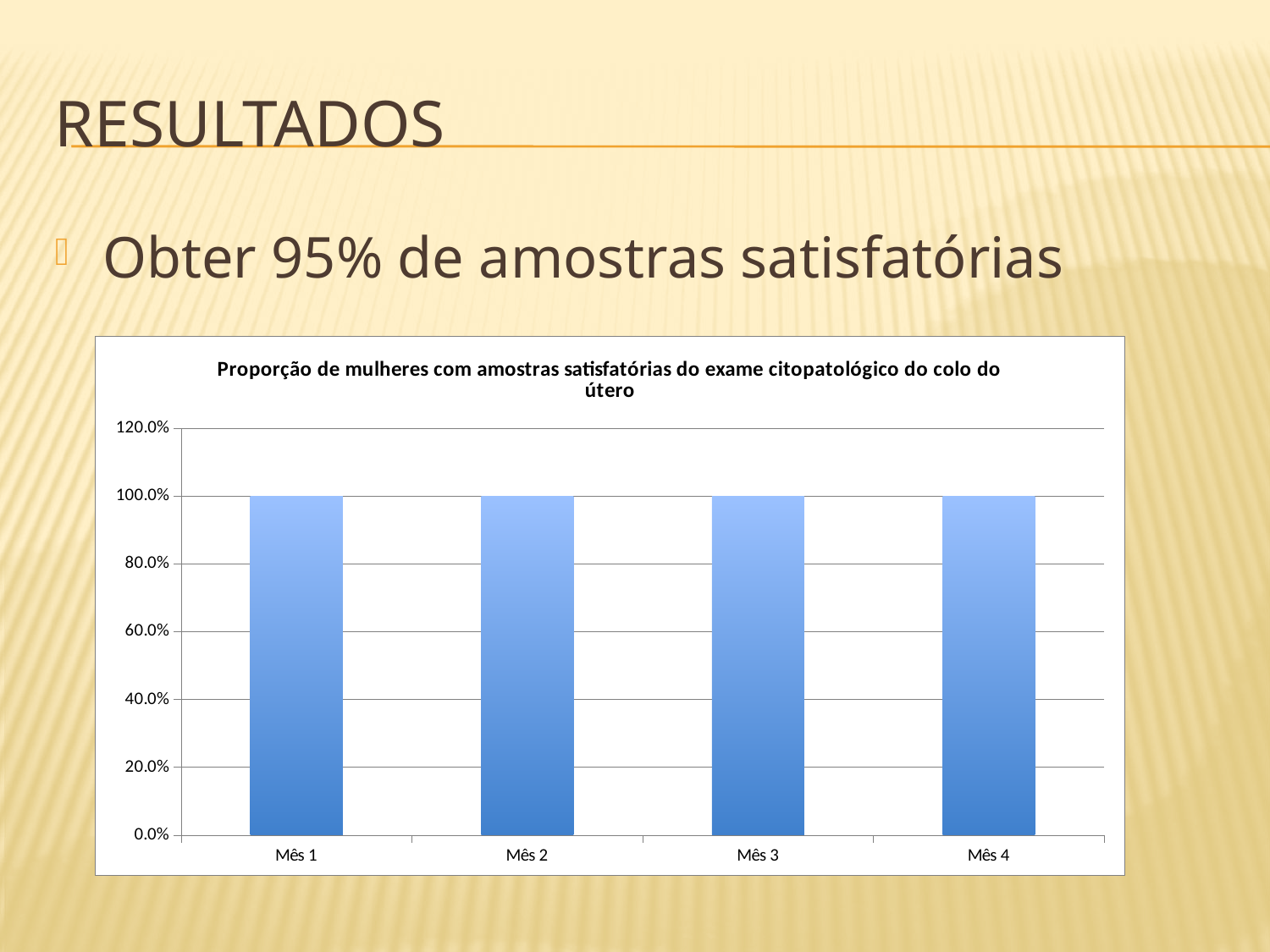
What is the label of the first category on the x axis? Mês 1 Is the value for Mês 2 greater or less than 80.0%? greater Do the values rise, fall, or stay the same from Mês 1 to Mês 4? stay the same What is the title of the chart? Proporção de mulheres com amostras satisfatórias do exame citopatológico do colo do útero What is the value for Mês 3? 100.0% How many categories are shown on the x axis of the chart? 4 What is the difference between the values for Mês 1 and Mês 3? 0.0% What is the value for Mês 2? 100.0% Is the value for Mês 4 greater or less than 120.0%? less What is the value for Mês 4? 100.0% What is the value for Mês 1? 100.0% What kind of chart is shown on the slide? bar chart